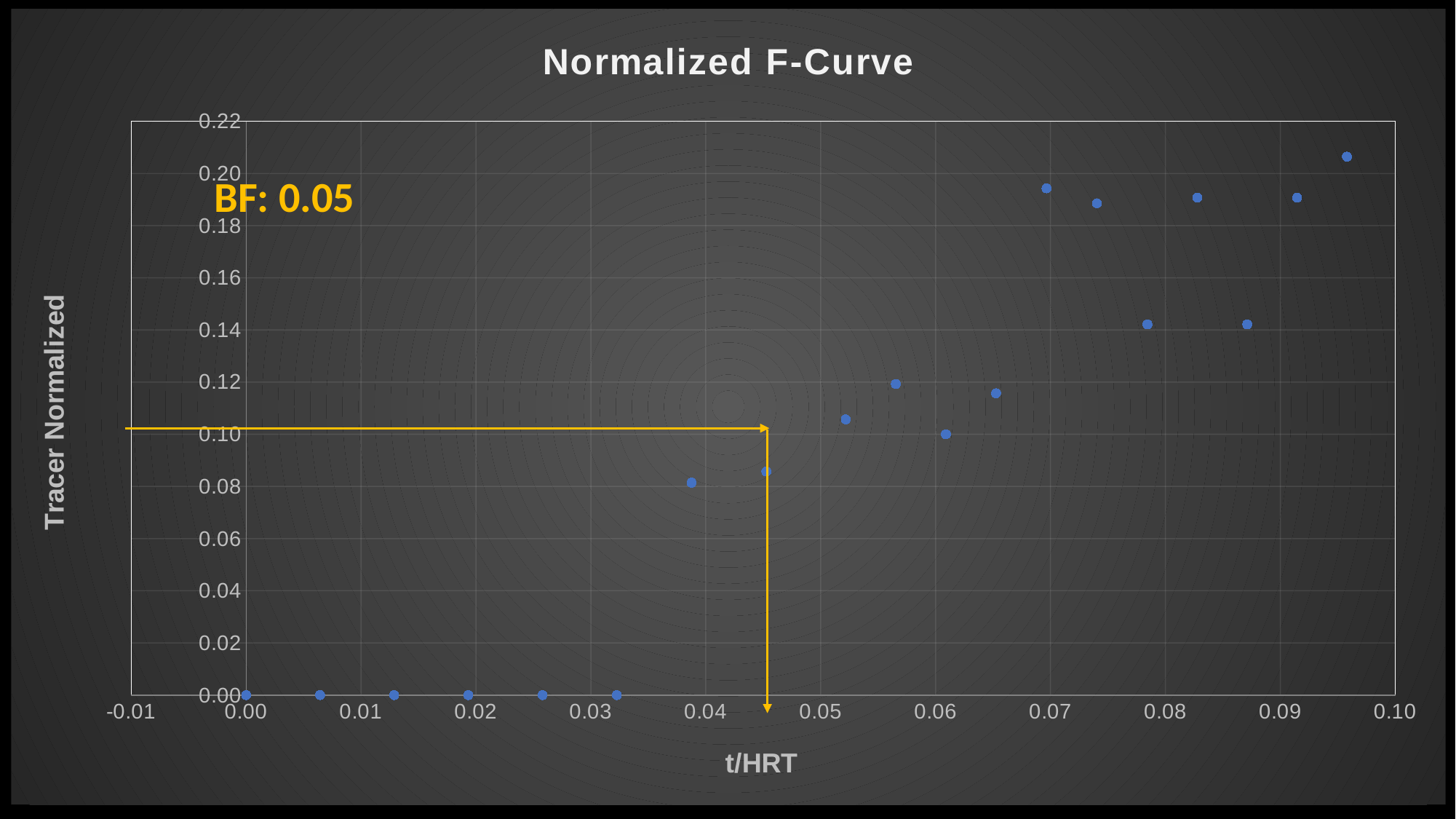
What is the title of the chart? Normalized F-Curve Is the value of the first non-zero point (near t/HRT 0.04) greater or less than 0.10? less Is the value of the point near t/HRT 0.07 greater or less than 0.18? greater How many data points are plotted in total? 19 How many points lie on the 0.00 line of the y axis? 6 What value does the annotation in the upper left of the chart give for BF? 0.05 What kind of chart is shown on the slide? Scatter chart Overall, do the Tracer Normalized values rise or fall as t/HRT increases? rise Is the value of the rightmost point (near t/HRT 0.10) greater or less than 0.20? greater What is the label of the x axis? t/HRT Is the highest point on the chart at the left end or the right end of the x axis? right end